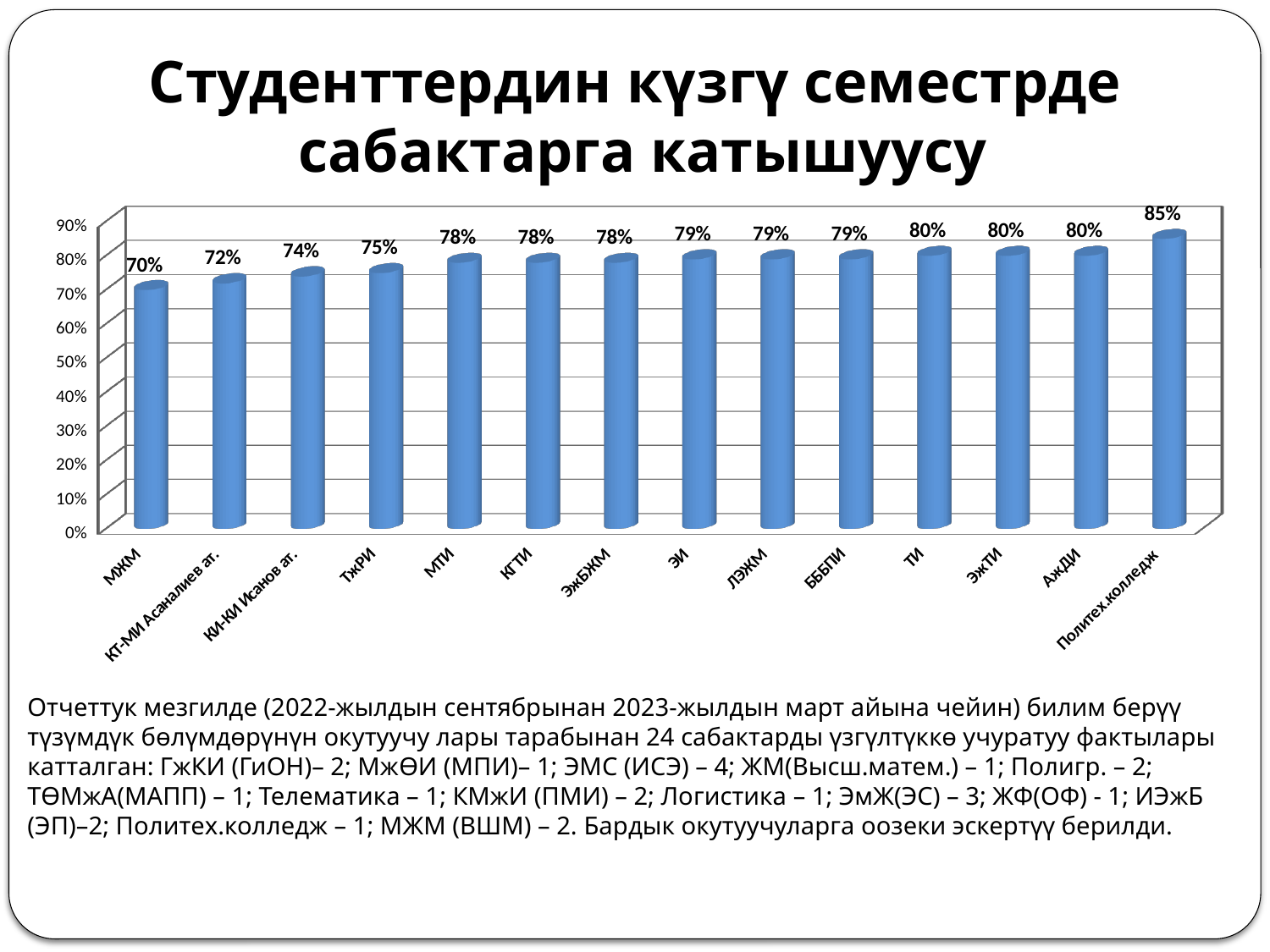
Which category has the lowest value? МЖМ What is the value for Политех.колледж? 85% How many categories are shown on the x axis? 14 What is the difference between the values for Политех.колледж and МЖМ? 15% What kind of chart is shown on the slide? bar chart What is the value for ТжРИ? 75% What is the value for МТИ? 78% Do the values rise or fall from left to right along the x axis? rise Which category has the highest value? Политех.колледж Which is larger, the value for ТИ or the value for ТжРИ? ТИ What is the value for МЖМ? 70% Is the value for КИ-КИ Исанов ат. greater or less than 80%? less